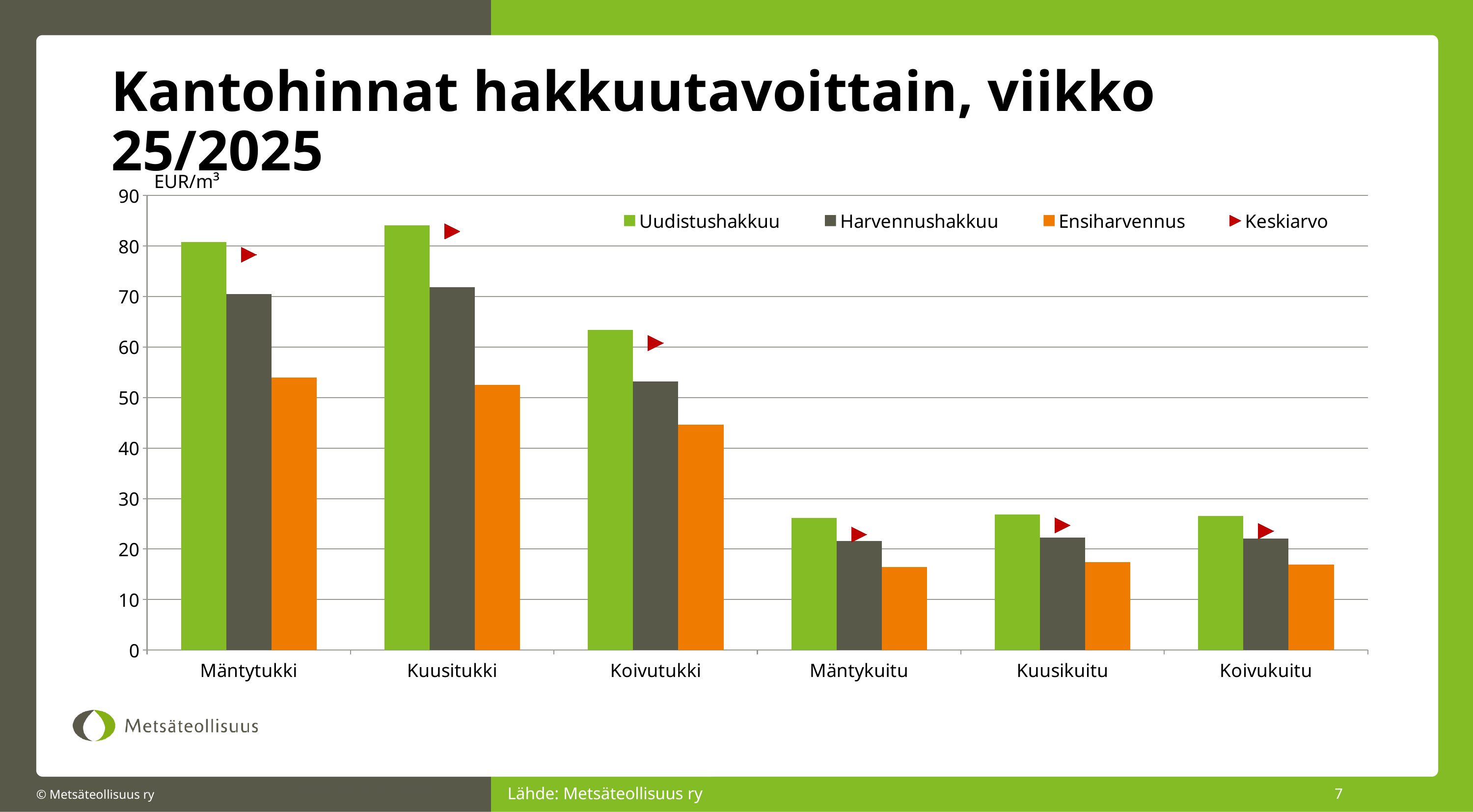
Which category has the highest Uudistushakkuu value? Kuusitukki Which series is the lowest bar in every category? Ensiharvennus What unit is shown on the y axis? EUR/m³ Is the Harvennushakkuu value for Koivutukki greater or less than 50? greater Is the Uudistushakkuu value for Mäntykuitu greater or less than 30? less Which is larger: the Uudistushakkuu value for Koivutukki or the Harvennushakkuu value for Mäntytukki? Harvennushakkuu value for Mäntytukki How many categories are shown on the x axis? 6 How many series does the legend list? 4 Is the Uudistushakkuu value for Mäntytukki greater or less than 70? greater What kind of chart is shown on the slide? bar chart